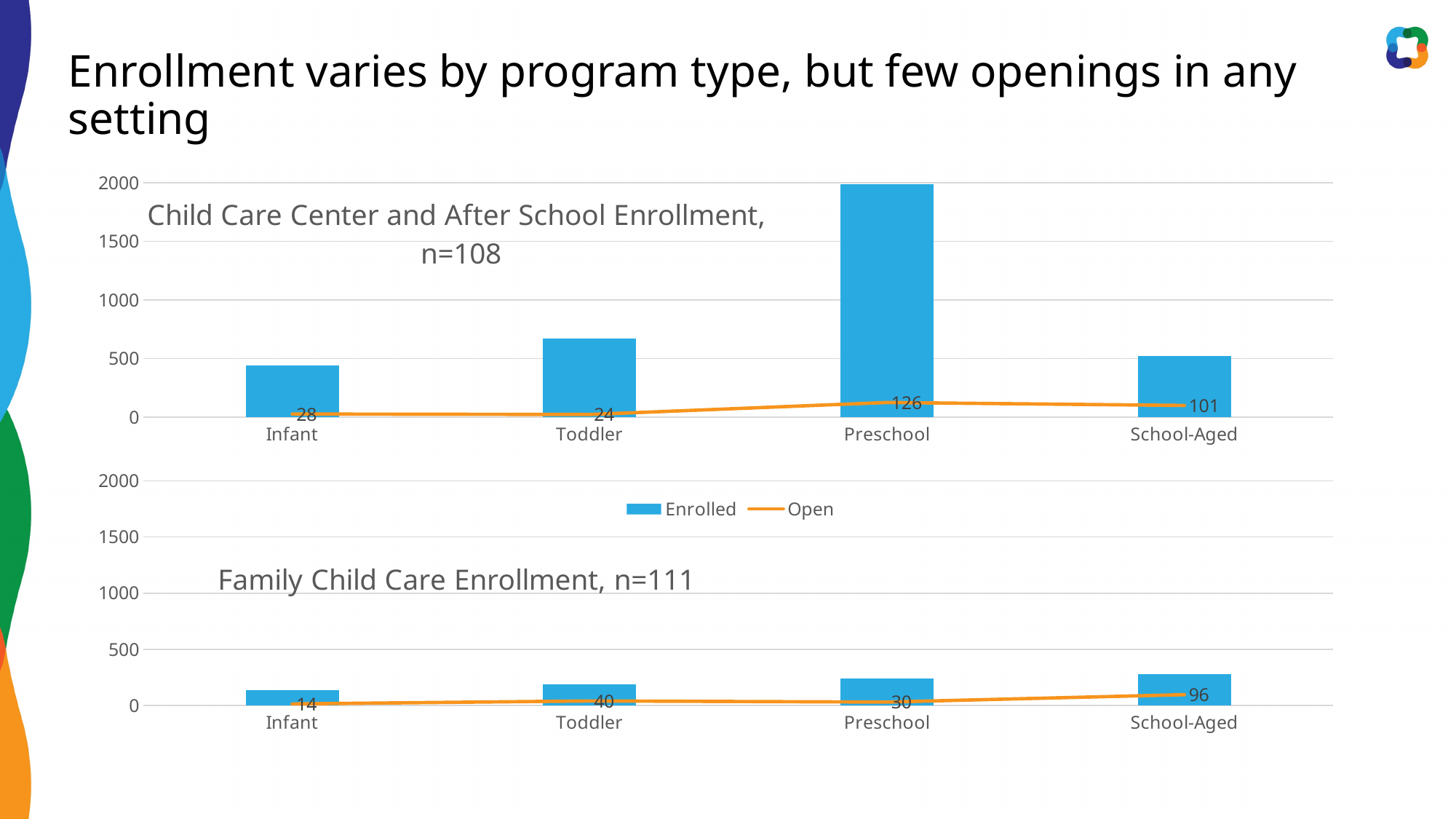
In the 'Family Child Care Enrollment, n=111' chart, which category has the highest Open value? School-Aged In the 'Family Child Care Enrollment, n=111' chart, what is the Open value for Infant? 14 In the 'Child Care Center and After School Enrollment, n=108' chart, what is the Open value for Toddler? 24 How many series does the legend list for the charts on the slide? 2 In the 'Child Care Center and After School Enrollment, n=108' chart, which category has the highest Enrolled value? Preschool In the 'Family Child Care Enrollment, n=111' chart, is the Open value for Toddler larger or smaller than the Open value for Preschool? larger In the 'Child Care Center and After School Enrollment, n=108' chart, what is the Open value for Preschool? 126 In the 'Child Care Center and After School Enrollment, n=108' chart, which category has the lowest Open value? Toddler In the 'Family Child Care Enrollment, n=111' chart, is the Enrolled value for School-Aged greater or less than 500? less In the 'Child Care Center and After School Enrollment, n=108' chart, is the Enrolled value for Preschool greater or less than 1500? greater In the 'Child Care Center and After School Enrollment, n=108' chart, what is the difference between the Open values for Preschool and School-Aged? 25 In the 'Family Child Care Enrollment, n=111' chart, what is the Open value for School-Aged? 96